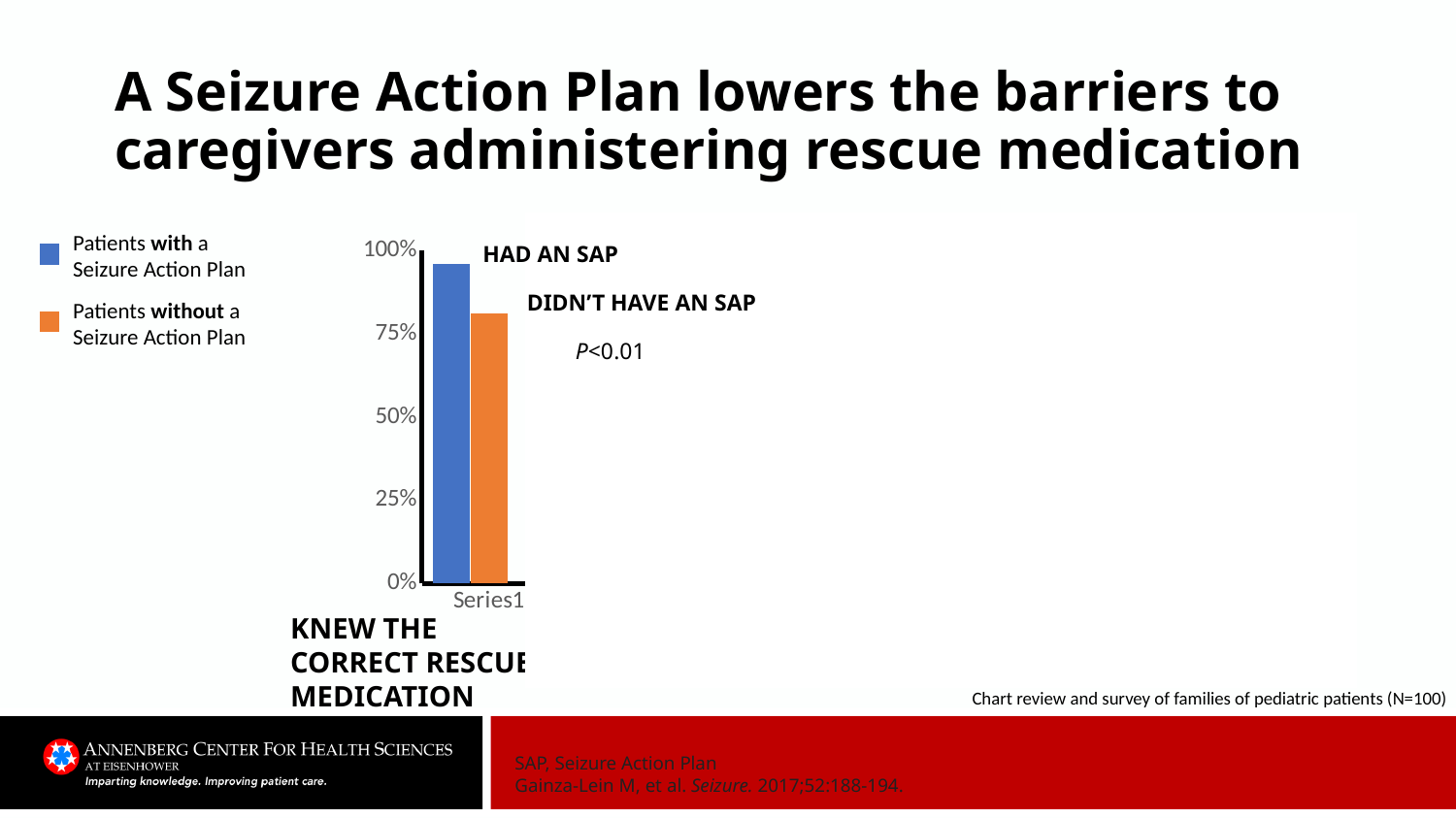
Is the value for patients without a Seizure Action Plan greater or less than 100%? less What P value is printed next to the chart? P<0.01 Which group has the taller bar: patients with a Seizure Action Plan or patients without a Seizure Action Plan? Patients with a Seizure Action Plan Is the value for patients with a Seizure Action Plan greater or less than 75%? greater How many bars are plotted in the chart? 2 Is the value for patients without a Seizure Action Plan greater or less than 50%? greater What kind of chart is shown on the slide? bar chart What category label appears below the bars on the horizontal axis? Series1 Which group has the highest bar in the chart? Patients with a Seizure Action Plan Which group has the lowest bar in the chart? Patients without a Seizure Action Plan What colour is the bar for patients with a Seizure Action Plan? blue What is the highest value shown on the vertical axis of the chart? 100%